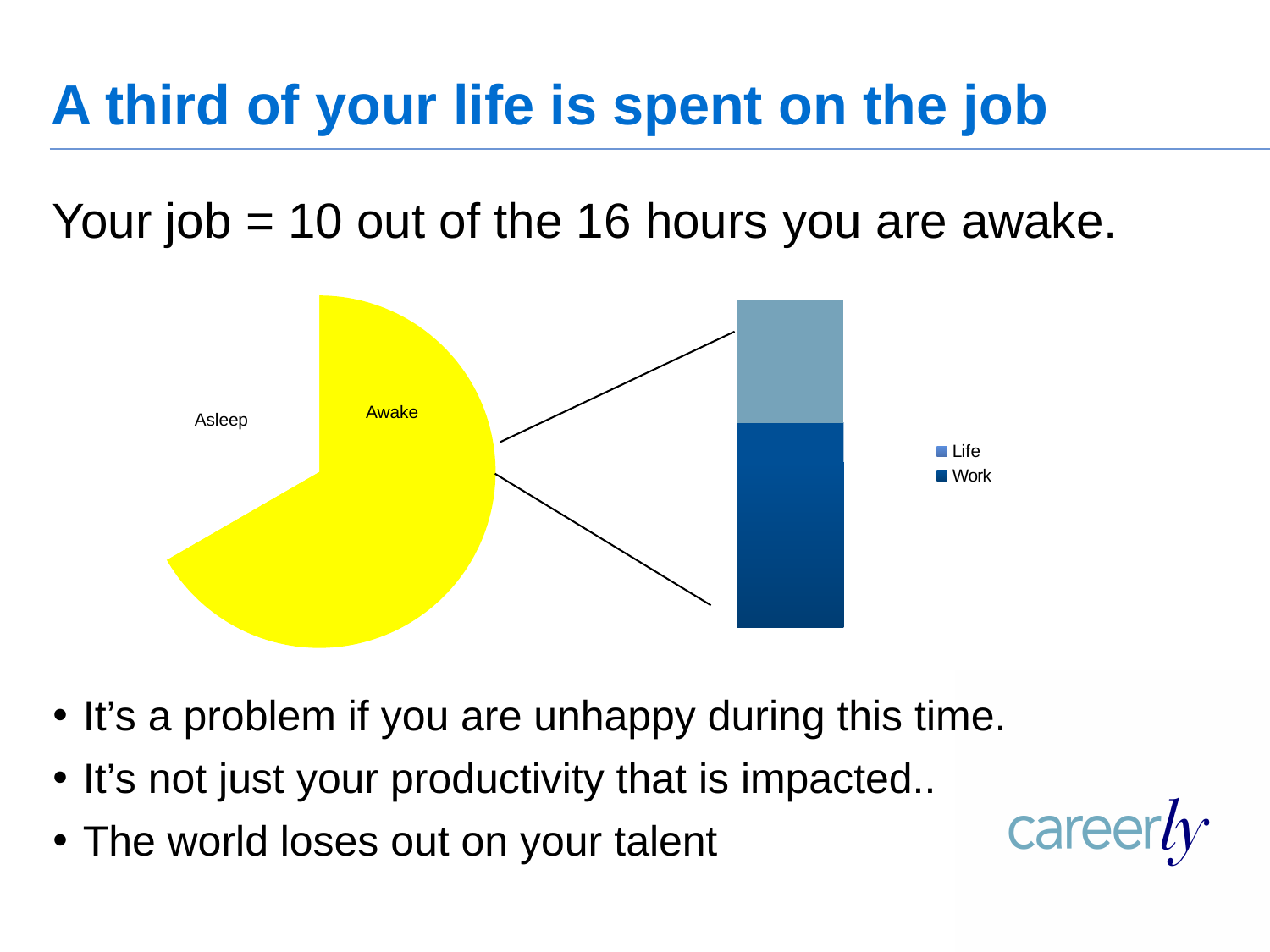
What kind of chart is on the right side of the slide, next to the legend? bar chart In the stacked bar chart, which series is shown in the darker blue? Work What colour is the Awake slice of the pie chart? yellow Which slice of the pie chart is connected by lines to the stacked bar? Awake In the pie chart, which slice is the smallest? Asleep In the pie chart, which slice is larger, Asleep or Awake? Awake What kind of chart is on the left side of the slide? pie chart In the pie chart, how many slices are labelled? 2 In the pie chart, which slice is the largest? Awake How many series does the legend of the stacked bar chart list? 2 In the stacked bar chart, which segment is larger, Life or Work? Work